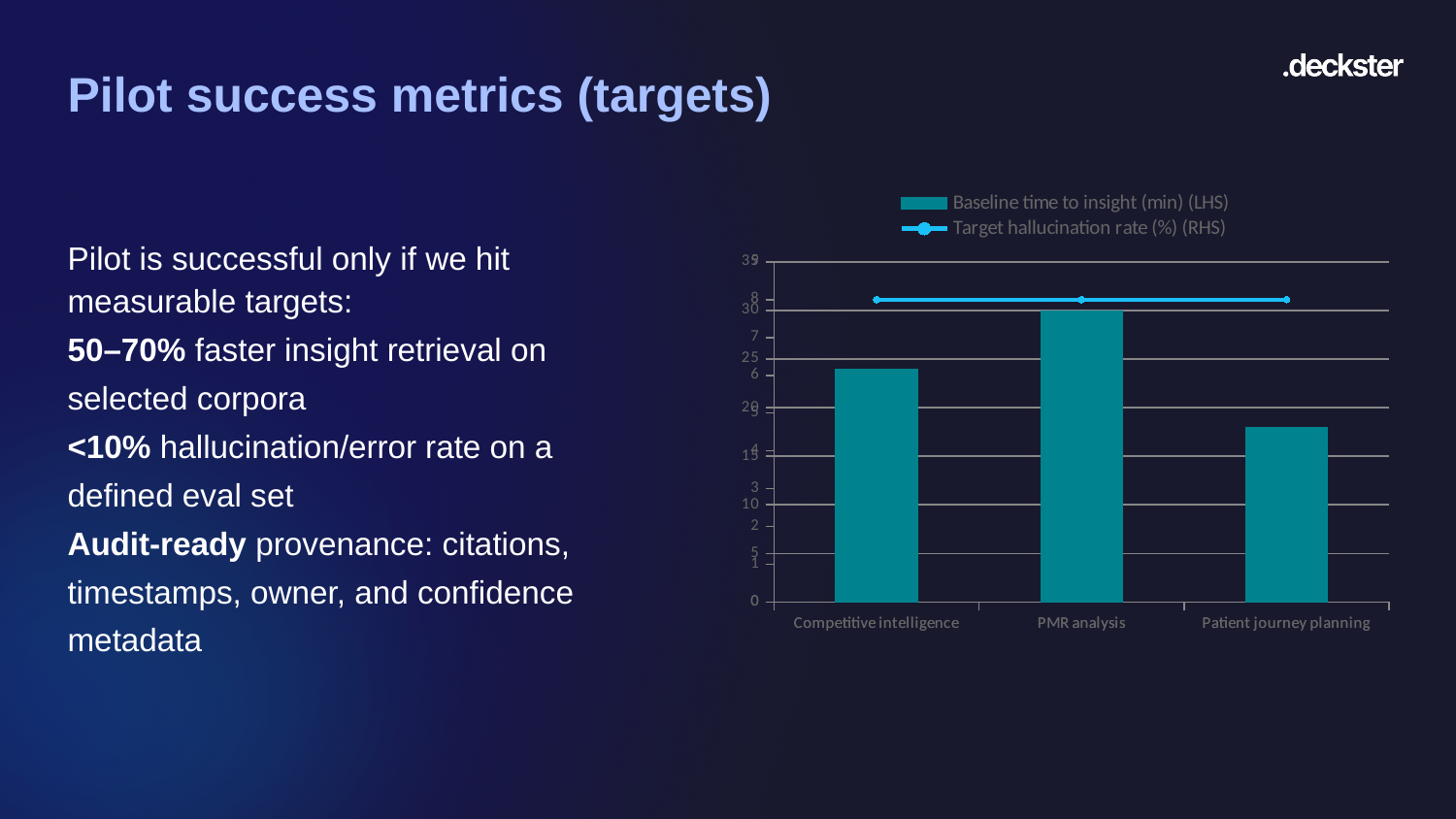
How many categories are shown on the x axis of the chart? 3 Which has a larger Baseline time to insight bar: Competitive intelligence or Patient journey planning? Competitive intelligence Is the Baseline time to insight value for Patient journey planning greater or less than 20? less Which has a larger Baseline time to insight bar: PMR analysis or Competitive intelligence? PMR analysis Is the Baseline time to insight value for PMR analysis greater or less than 25? greater Is the Baseline time to insight value for Competitive intelligence greater or less than 20? greater Which series in the legend is plotted on the right-hand side (RHS) axis? Target hallucination rate (%) What kind of chart is shown on the slide? Bar chart with a line overlay How many series does the chart legend list? 2 Which category has the highest Baseline time to insight (min) bar? PMR analysis Which category has the lowest Baseline time to insight (min) bar? Patient journey planning Does the Target hallucination rate (%) line rise, fall, or stay flat across the categories? Stays flat